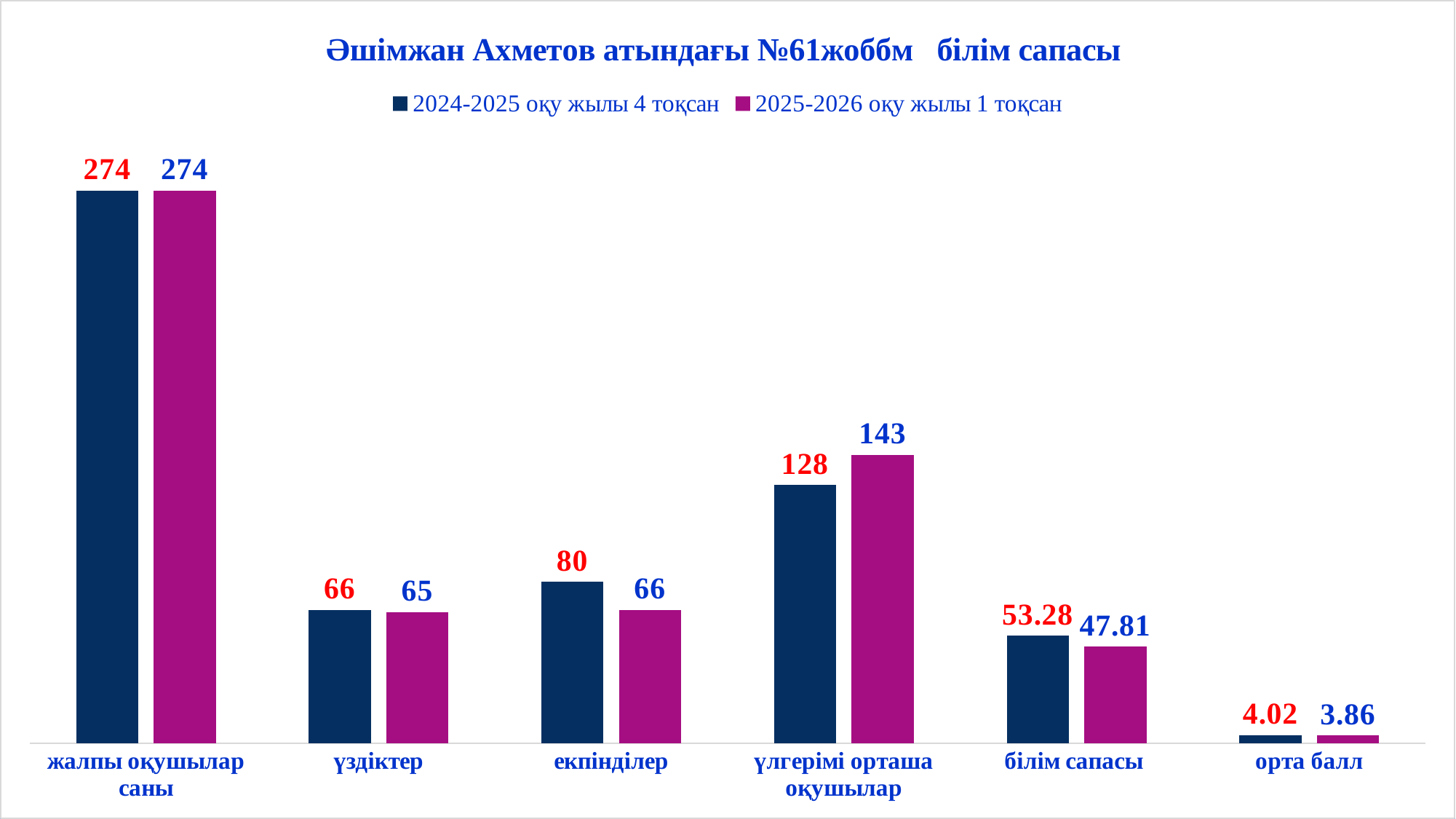
What is the difference between the two series' values for "екпінділер"? 14 For "білім сапасы", which series has the larger value? 2024-2025 оқу жылы 4 тоқсан What type of chart is shown on the slide? bar chart Which category has the highest value in the "2025-2026 оқу жылы 1 тоқсан" series? жалпы оқушылар саны How many categories are shown on the x axis? 6 Which category has the lowest value in the "2024-2025 оқу жылы 4 тоқсан" series? орта балл What is the value for "екпінділер" in the "2024-2025 оқу жылы 4 тоқсан" series? 80 What is the difference between the two series' values for "үлгерімі орташа оқушылар"? 15 How many series does the legend list? 2 What is the value for "білім сапасы" in the "2025-2026 оқу жылы 1 тоқсан" series? 47.81 What is the value for "орта балл" in the "2024-2025 оқу жылы 4 тоқсан" series? 4.02 What is the value for "үлгерімі орташа оқушылар" in the "2025-2026 оқу жылы 1 тоқсан" series? 143